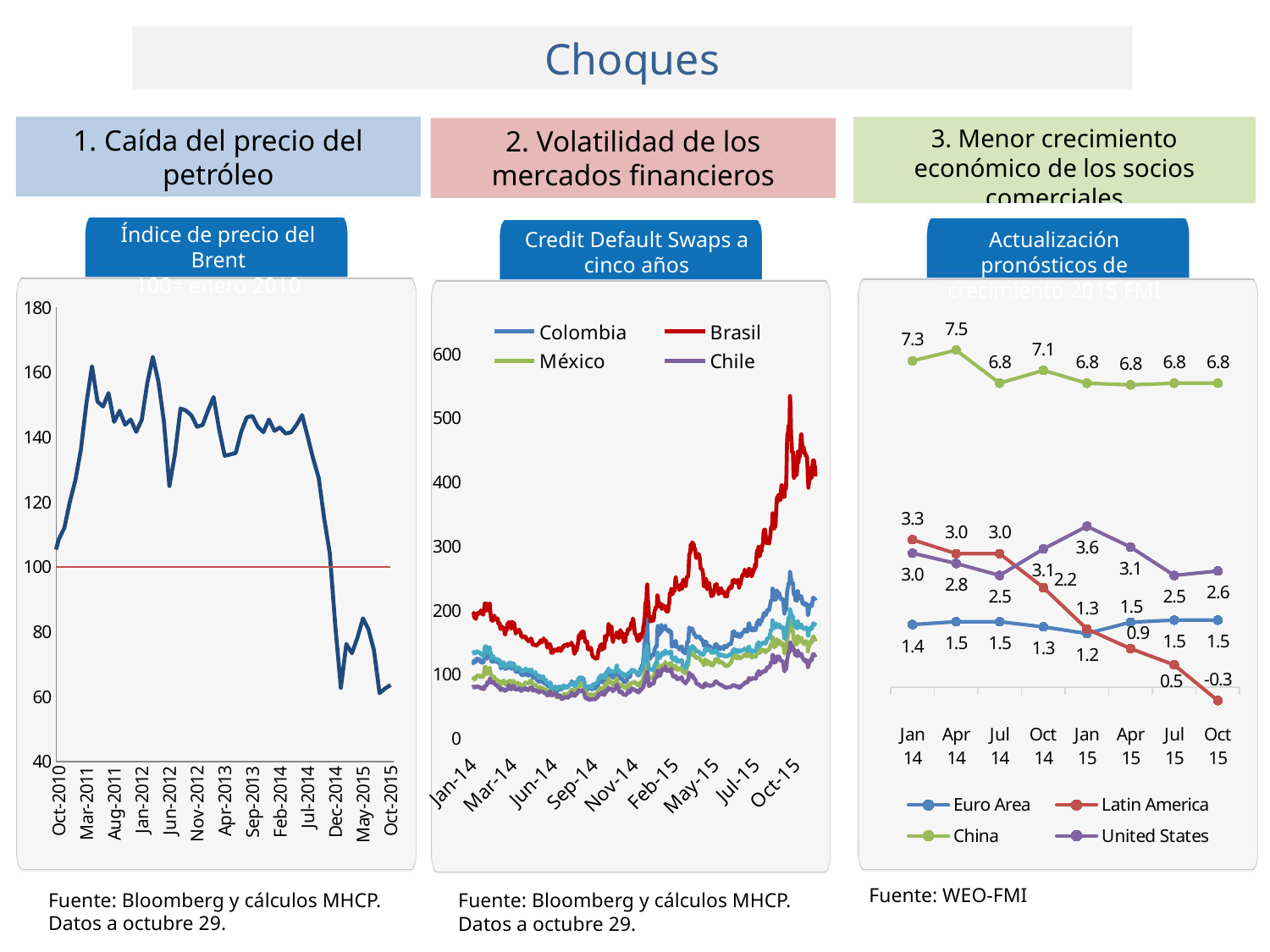
In the chart titled 'Credit Default Swaps a cinco años', which series is higher at Oct-15, Brasil or Chile? Brasil In the chart titled 'Índice de precio del Brent', is the value at Oct-2015 greater or less than 80? less In the chart titled 'Actualización pronósticos de crecimiento 2015 FMI', how many dates are plotted on the x axis? 8 In the chart titled 'Actualización pronósticos de crecimiento 2015 FMI', what is the value for China at Oct 15? 6.8 In the chart titled 'Actualización pronósticos de crecimiento 2015 FMI', does the Latin America series rise or fall from Jan 14 to Oct 15? fall In the chart titled 'Credit Default Swaps a cinco años', how many countries does the legend list? 4 In the chart titled 'Actualización pronósticos de crecimiento 2015 FMI', at which date does the United States series reach its highest value? Jan 15 In the chart titled 'Índice de precio del Brent', is the value at Jan-2012 greater or less than 140? greater In the chart titled 'Actualización pronósticos de crecimiento 2015 FMI', how many series does the legend list? 4 What kind of chart is the 'Índice de precio del Brent' chart? line chart In the chart titled 'Actualización pronósticos de crecimiento 2015 FMI', what is the difference between China's value at Apr 14 and at Jul 14? 0.7 In the chart titled 'Actualización pronósticos de crecimiento 2015 FMI', what is the value for Latin America at Oct 15? -0.3